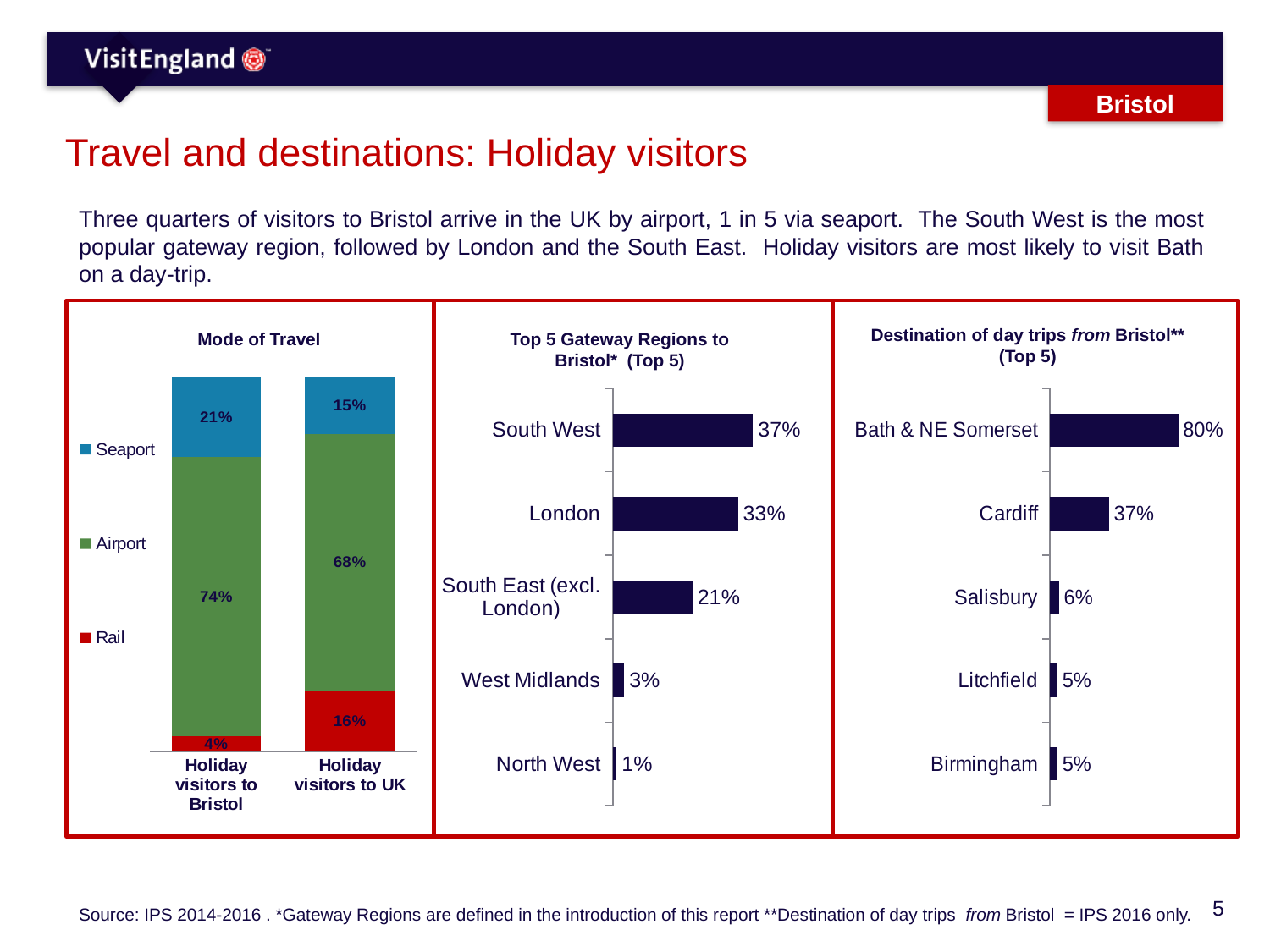
In the Top 5 Gateway Regions to Bristol chart, what is the value for London? 33% In the Mode of Travel chart, what percentage of holiday visitors to Bristol arrive by airport? 74% In the Destination of day trips from Bristol chart, what is the value for Cardiff? 37% In the Top 5 Gateway Regions to Bristol chart, which region has the lowest value? North West In the Destination of day trips from Bristol chart, which destination has the highest value? Bath & NE Somerset In the Mode of Travel chart, how many series does the legend list? 3 In the Mode of Travel chart, what is the difference between the rail share for holiday visitors to UK and for holiday visitors to Bristol? 12% In the Mode of Travel chart, which is larger: the airport share for holiday visitors to Bristol or for holiday visitors to UK? Holiday visitors to Bristol In the Mode of Travel chart, what percentage of holiday visitors to UK arrive by seaport? 15% What kind of chart is the Top 5 Gateway Regions to Bristol chart? Bar chart In the Top 5 Gateway Regions to Bristol chart, what is the difference between South West and South East (excl. London)? 16% How many destinations are shown in the Destination of day trips from Bristol chart? 5